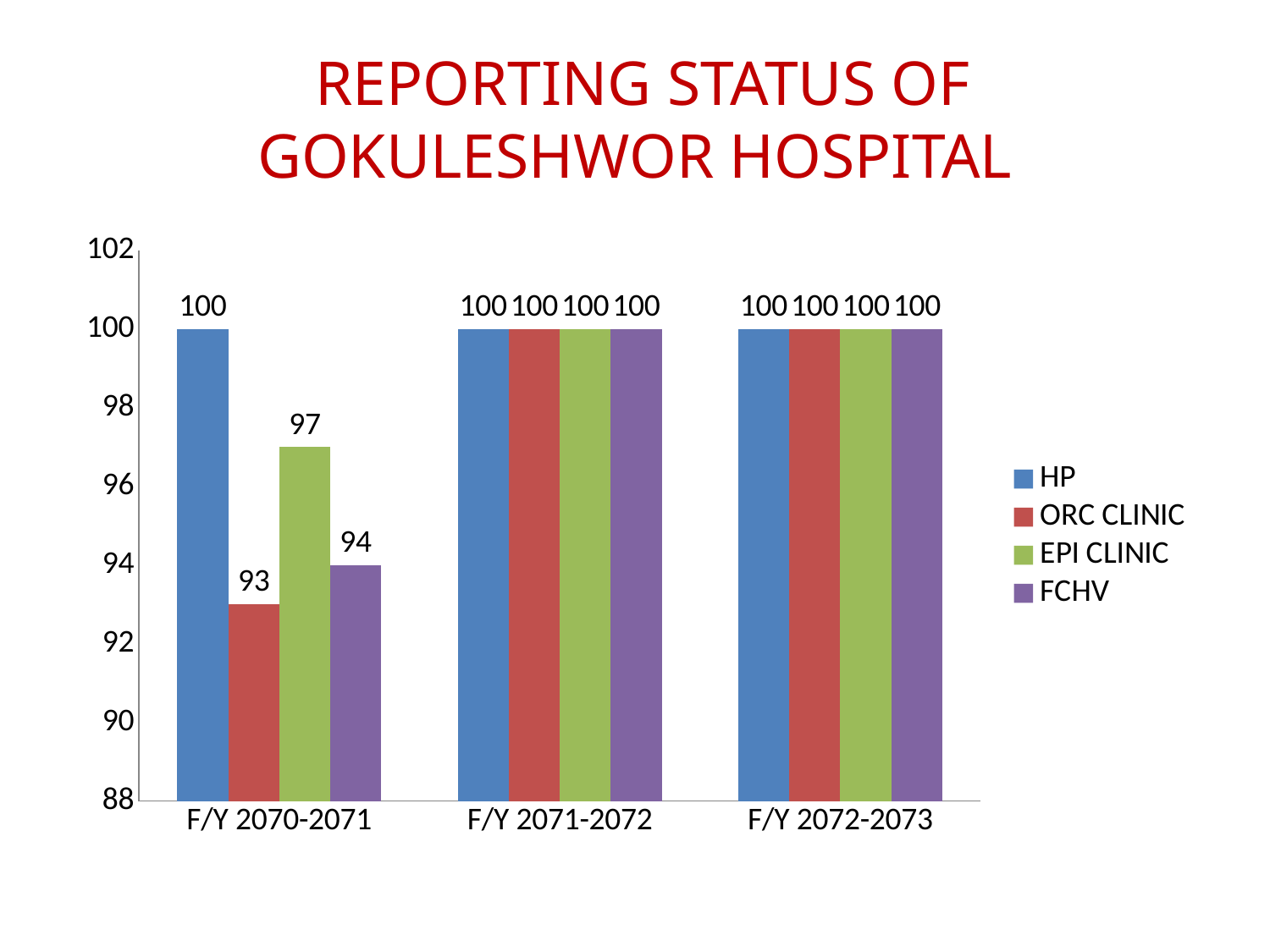
Does the ORC CLINIC value rise or fall from F/Y 2070-2071 to F/Y 2071-2072? Rise How many series does the legend list? 4 Which series has the lowest value in F/Y 2070-2071? ORC CLINIC Which series has the highest value in F/Y 2070-2071? HP What is the value for FCHV in F/Y 2070-2071? 94 What is the value for EPI CLINIC in F/Y 2070-2071? 97 What kind of chart is shown on the slide? Bar chart What is the difference between the HP and ORC CLINIC values in F/Y 2070-2071? 7 What is the value for HP in F/Y 2071-2072? 100 Which is larger in F/Y 2070-2071, EPI CLINIC or FCHV? EPI CLINIC How many fiscal year categories are shown on the x axis? 3 What is the value for ORC CLINIC in F/Y 2070-2071? 93